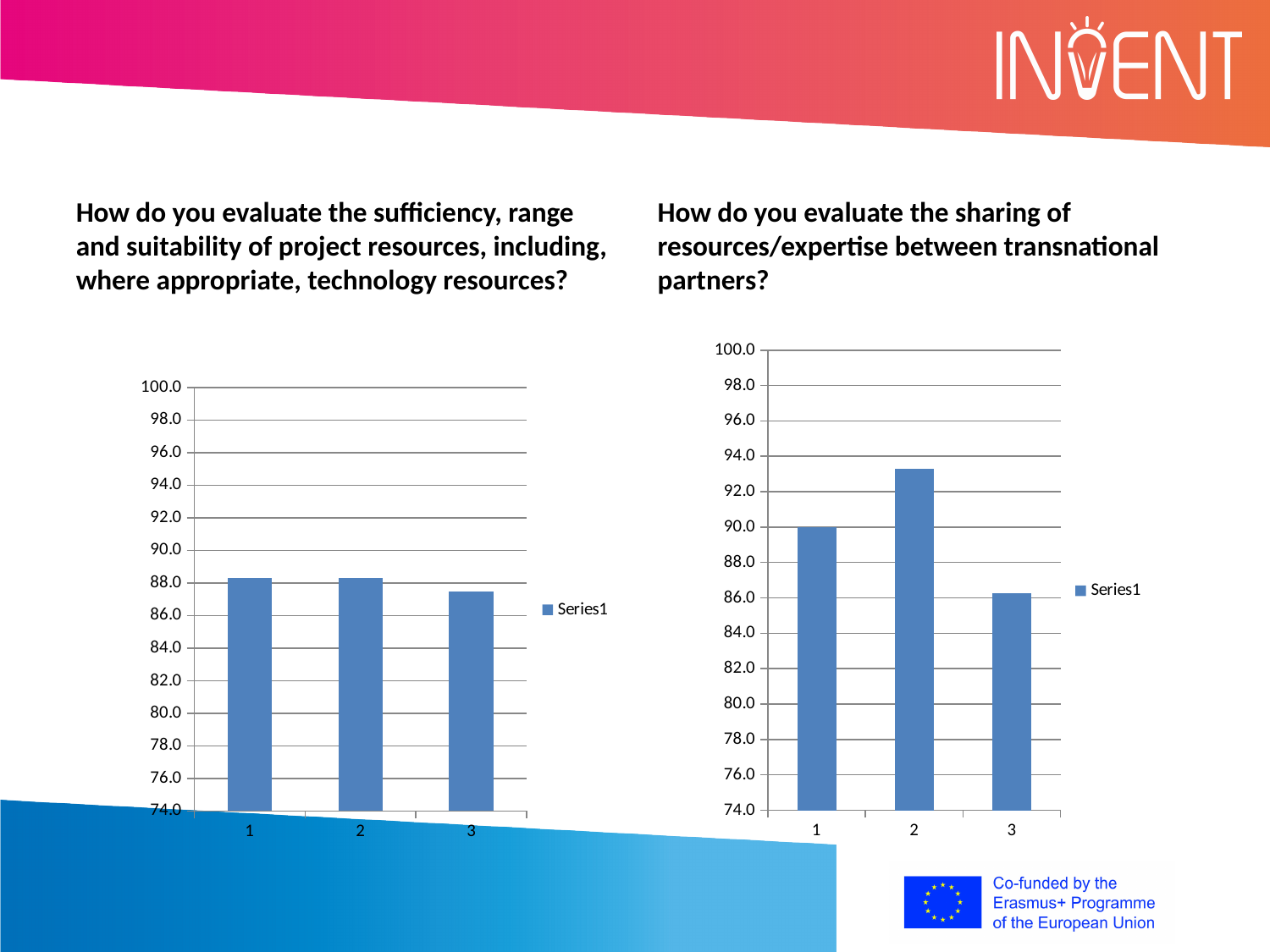
What is the name of the series shown in the legend of the right chart? Series1 In the right chart, is the value for category 3 greater or less than 88.0? less In the left chart, which category has the lowest bar? 3 In the right chart, which category has the lowest bar? 3 How many categories are shown on the x axis of the right chart? 3 In the right chart, which is larger, the value for category 1 or the value for category 3? category 1 What kind of chart is the left chart on the slide? bar chart In the left chart, is the value for category 3 greater or less than 88.0? less In the right chart, is the value for category 2 greater or less than 92.0? greater How many series does the legend of the left chart list? 1 In the right chart, what is the value for category 1? 90.0 In the right chart, which category has the highest bar? 2